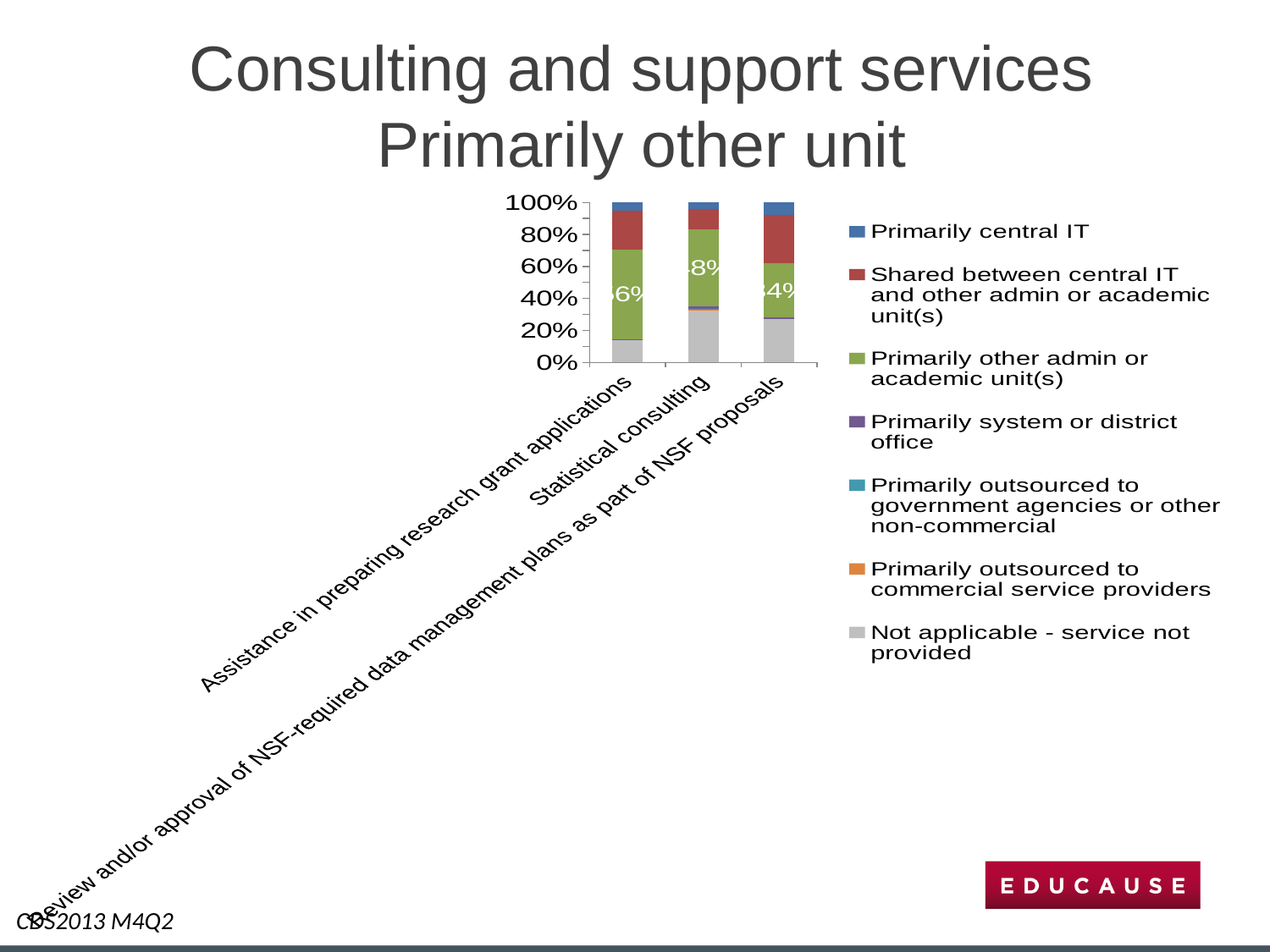
What kind of chart is shown on the slide? Stacked bar chart What is the title of the slide containing the chart? Consulting and support services Primarily other unit Which category has the smallest 'Primarily other admin or academic unit(s)' segment? Review and/or approval of NSF-required data management plans as part of NSF proposals Which category has the largest 'Primarily other admin or academic unit(s)' segment? Assistance in preparing research grant applications What colour represents 'Primarily central IT' in the chart's legend? Blue Is the 'Not applicable - service not provided' value for Assistance in preparing research grant applications greater or less than 20%? less Is the 'Primarily other admin or academic unit(s)' segment larger for Assistance in preparing research grant applications or for Statistical consulting? Assistance in preparing research grant applications Which category has the smallest 'Shared between central IT and other admin or academic unit(s)' segment? Statistical consulting Is the 'Not applicable - service not provided' segment larger for Statistical consulting or for Assistance in preparing research grant applications? Statistical consulting How many series does the chart's legend list? 7 How many categories are plotted along the x axis of the chart? 3 Is the 'Not applicable - service not provided' value for Statistical consulting greater or less than 20%? greater